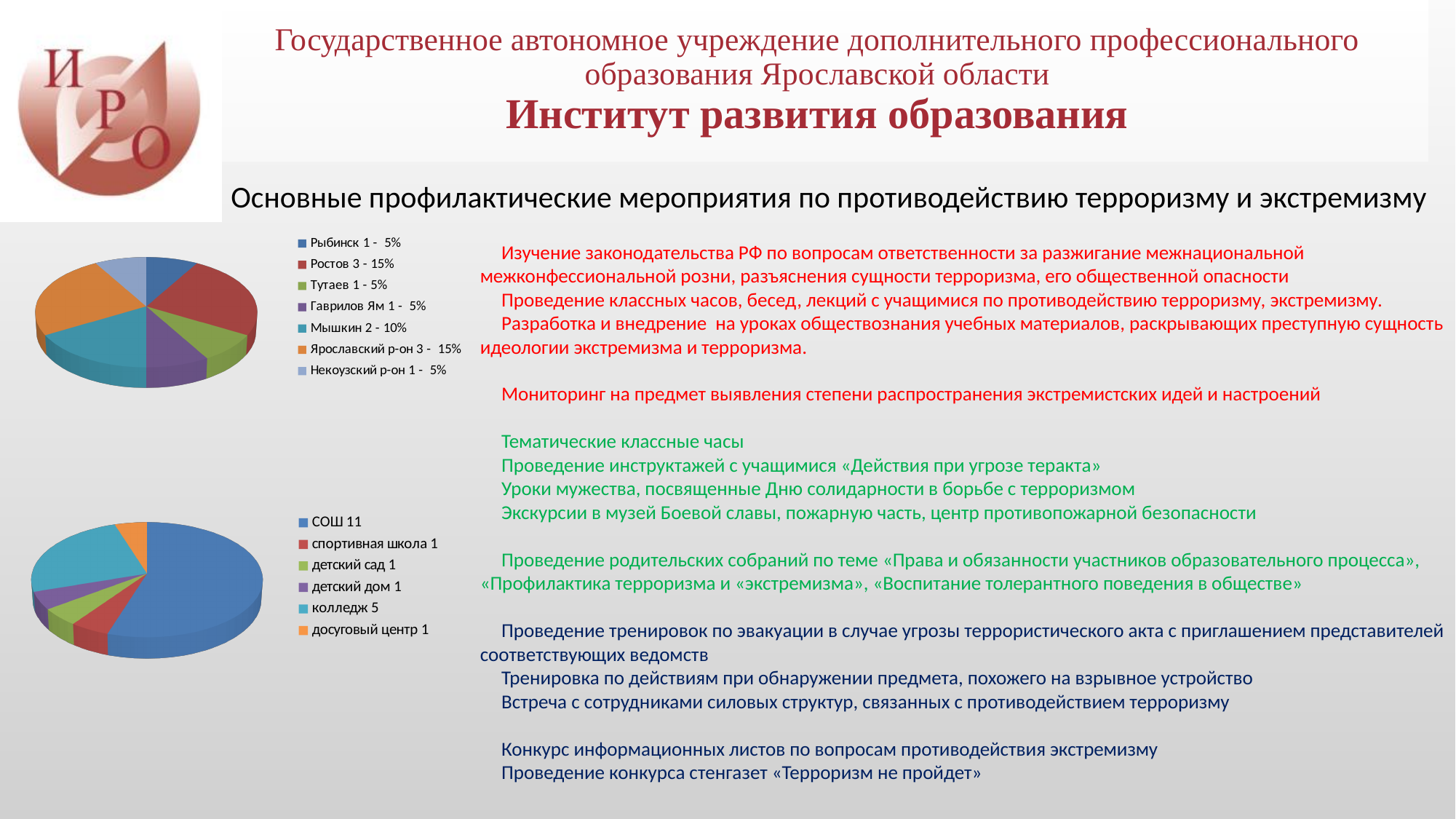
In the top-left pie chart, what is the difference in percentage points between Ярославский р-он and Некоузский р-он? 10 In the top-left pie chart, which is larger, the value for Ростов or the value for Мышкин? Ростов In the top-left pie chart, what percentage is shown for Мышкин? 10% In the bottom-left pie chart, what is the total of all the values listed in the legend? 20 In the bottom-left pie chart, what colour is the slice for СОШ? blue What kind of chart is the top-left chart on the slide? pie chart How many categories does the legend of the top-left pie chart list? 7 In the bottom-left pie chart, what is the difference between the values for СОШ and колледж? 6 In the top-left pie chart, what value is shown for Ростов? 3 - 15% How many categories does the legend of the bottom-left pie chart list? 6 In the bottom-left pie chart, what value is shown for колледж? 5 In the bottom-left pie chart, which category has the highest value? СОШ